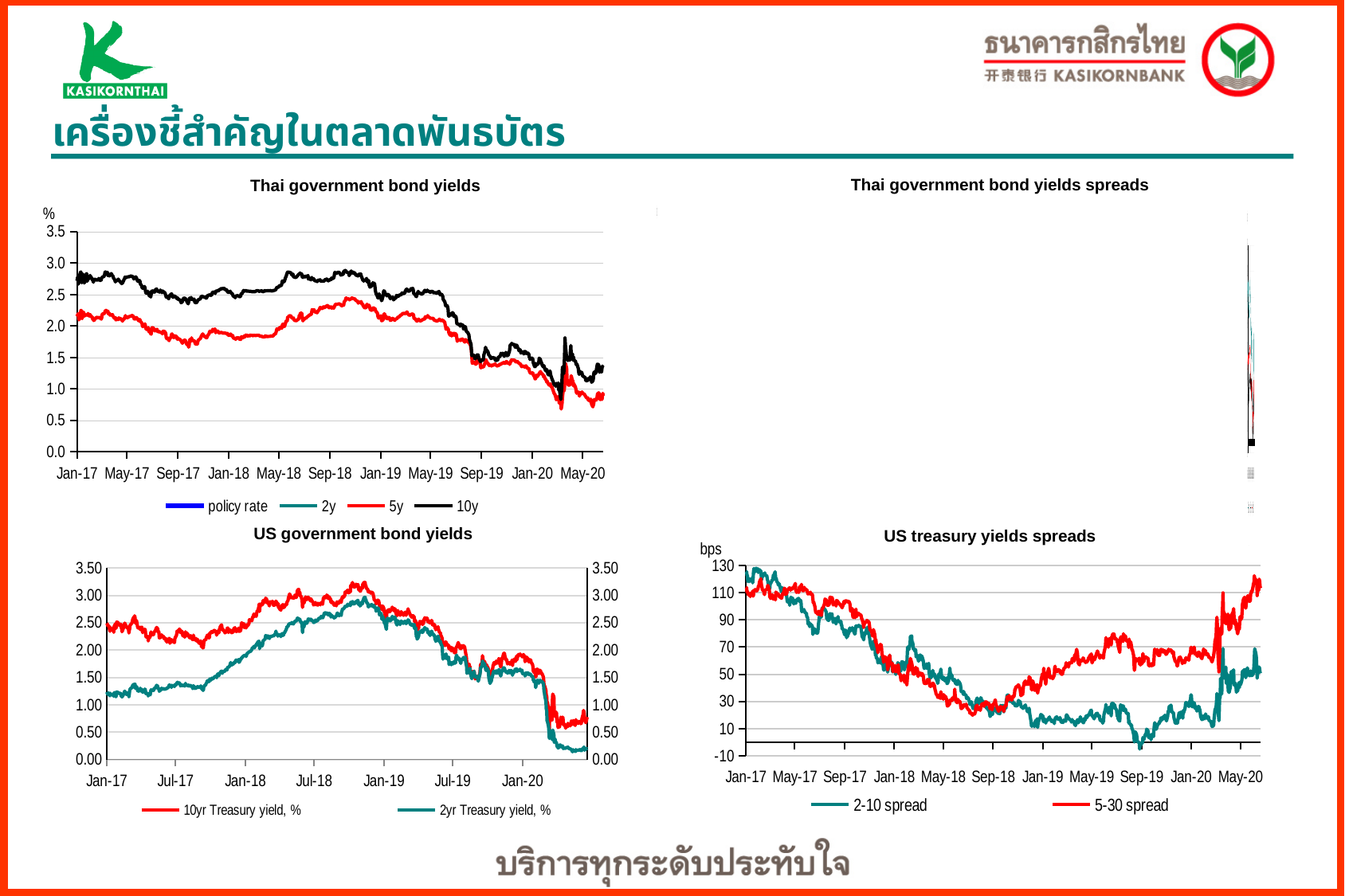
In the "Thai government bond yields" chart, is the 5y yield in May-20 greater or less than 1.5? less What kind of chart is the "Thai government bond yields" chart? line chart In the "US government bond yields" chart, is the 2yr Treasury yield at the end of the series greater or less than 0.50? less In the "Thai government bond yields" chart, does the 10y yield overall rise or fall from Jan-17 to May-20? fall In the "Thai government bond yields" chart, which line is higher in Jan-17, 5y or 10y? 10y In the "Thai government bond yields" chart, is the 10y yield in Jan-17 greater or less than 2.5? greater In the "US treasury yields spreads" chart, what unit is shown on the y axis? bps In the "US treasury yields spreads" chart, which series is higher in May-20, the 2-10 spread or the 5-30 spread? 5-30 spread How many series does the legend of the "US government bond yields" chart list? 2 How many series does the legend of the "Thai government bond yields" chart list? 4